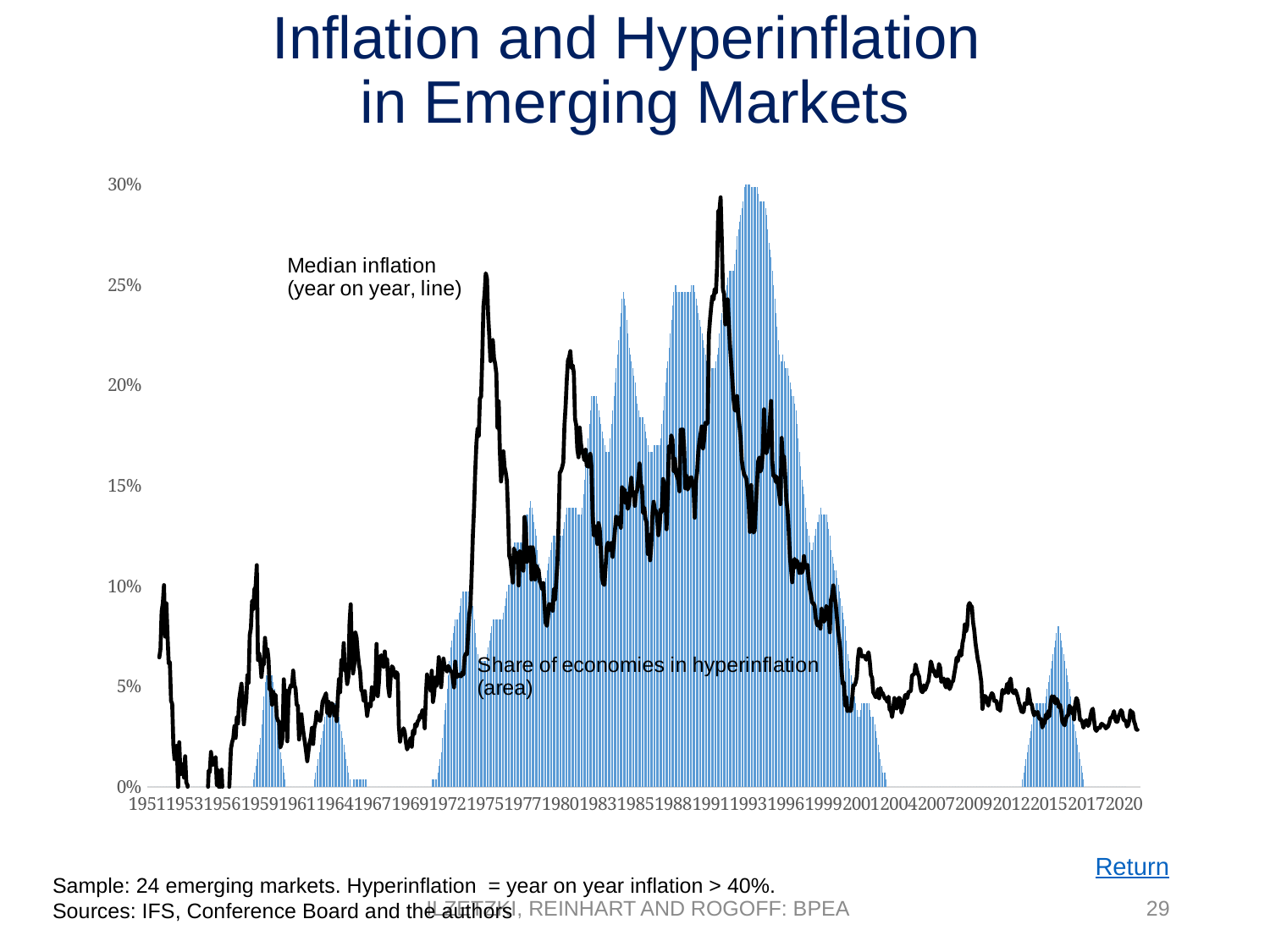
What is the title of the chart? Inflation and Hyperinflation in Emerging Markets Is the peak of the share of economies in hyperinflation around 1993 greater or less than 25%? greater Is the share of economies in hyperinflation in 2004 greater or less than 5%? less Is the peak of median inflation around 1991 greater or less than 25%? greater Which series is drawn as a line? Median inflation (year on year) Does the share of economies in hyperinflation generally rise or fall between 1972 and 1993? rise Does median inflation generally rise or fall between 1993 and 2020? fall What kind of chart is shown on the slide? A combined line and area chart How many data series does the chart show? 2